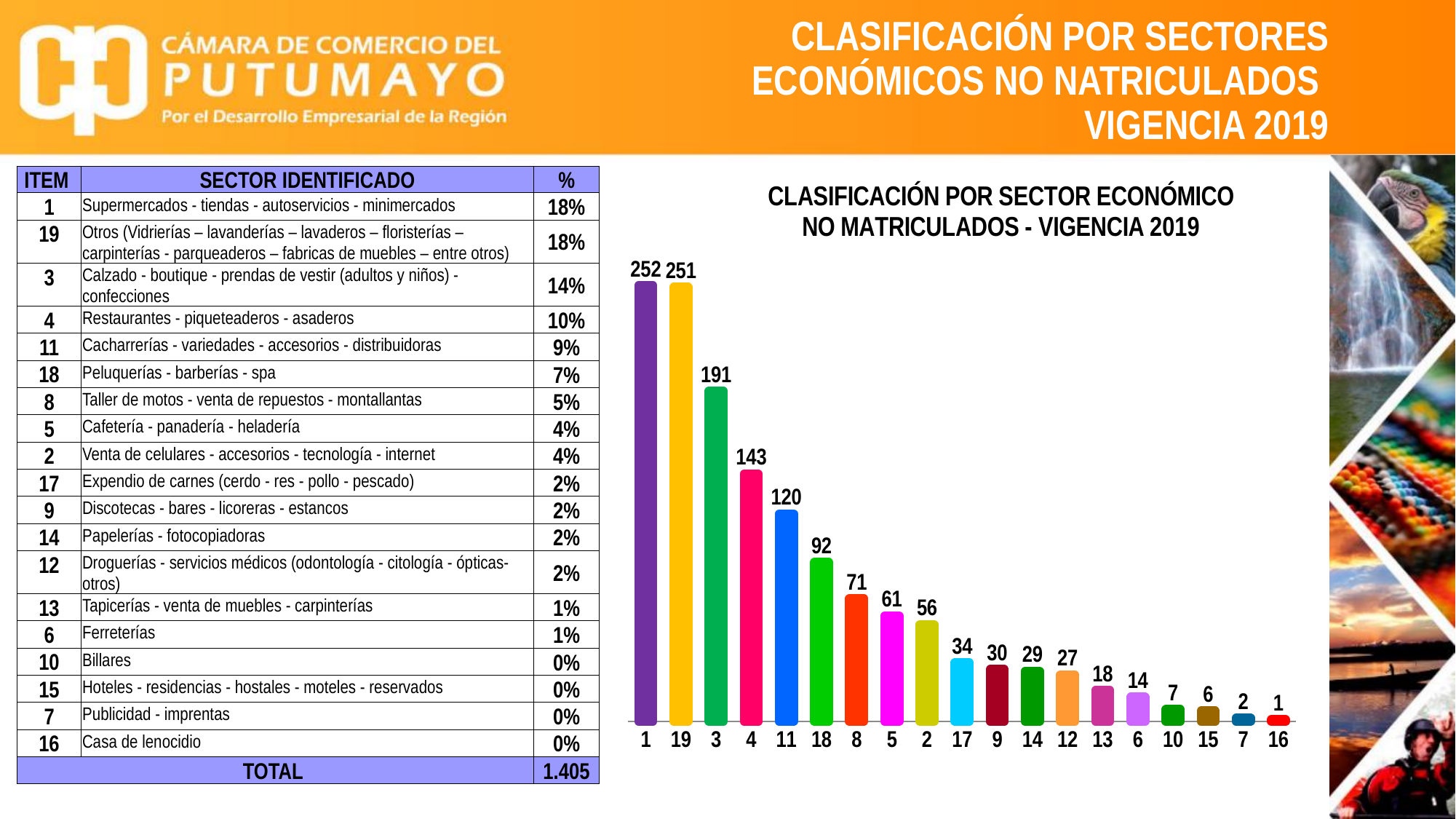
How many categories are shown on the x axis of the chart? 19 What is the difference between the values for category 1 and category 19? 1 Do the values rise or fall from left to right along the x axis? fall What is the title of the chart? CLASIFICACIÓN POR SECTOR ECONÓMICO NO MATRICULADOS - VIGENCIA 2019 Which category has the lowest value in the chart? 16 What is the value for category 11 in the chart? 120 What is the value for category 3 in the chart? 191 Which category has the highest value in the chart? 1 What is the difference between the values for category 4 and category 18? 51 What kind of chart is shown on the slide? bar chart What is the value for category 17 in the chart? 34 Which is larger, the value for category 8 or the value for category 5? 8